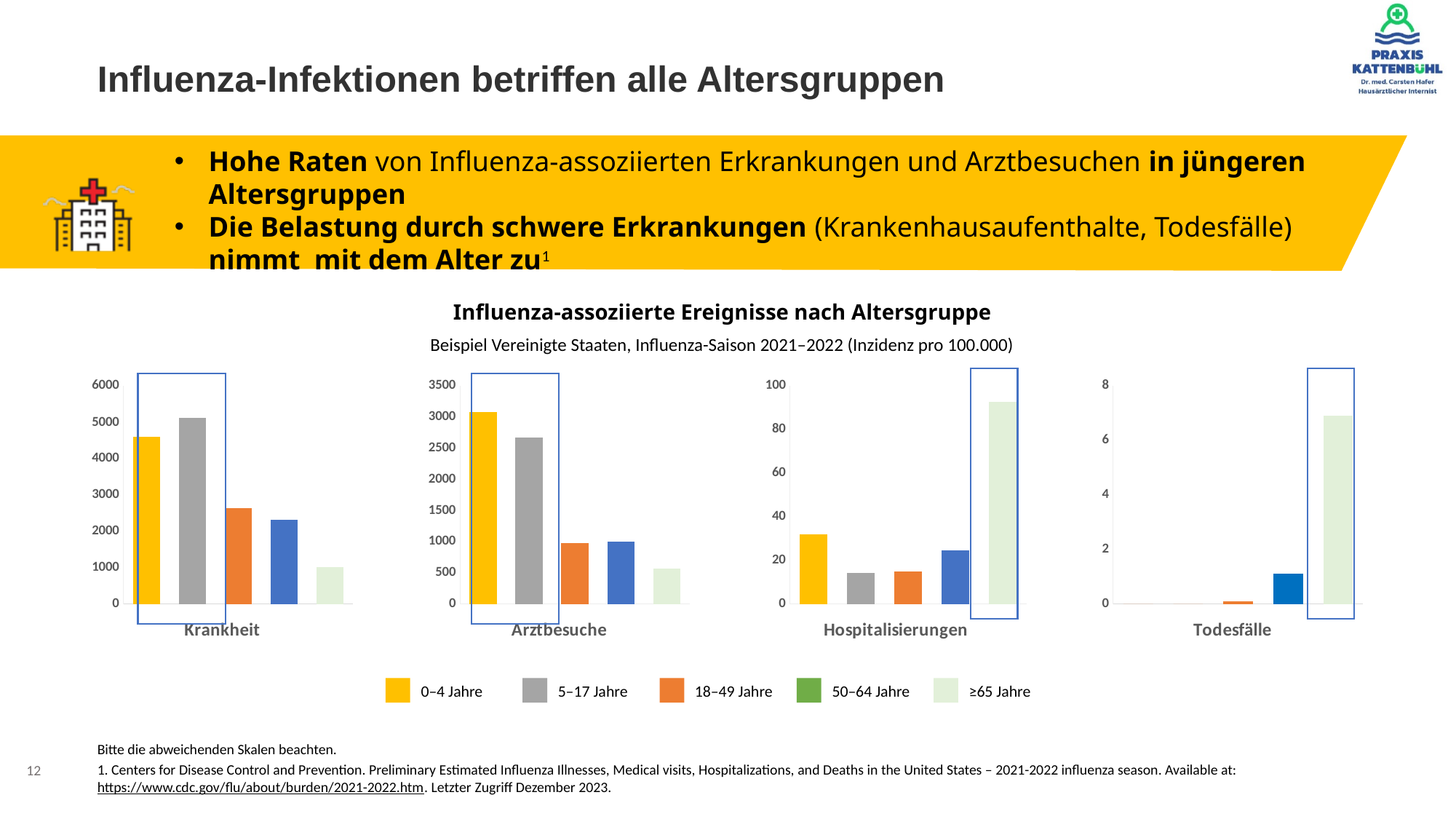
In the Arztbesuche chart, which age group has the highest value? 0–4 Jahre In the Hospitalisierungen chart, which age group has the highest value? ≥65 Jahre In the Krankheit chart, which age group has the highest value? 5–17 Jahre How many separate charts (panels) are shown on the slide? 4 In the Hospitalisierungen chart, is the value for ≥65 Jahre greater or less than 80? greater In the Krankheit chart, which age group has the lowest value? ≥65 Jahre How many age-group series does the legend list? 5 What kind of chart is used for the Krankheit panel? bar chart In the Krankheit chart, is the value for 0–4 Jahre greater or less than 4000? greater In the Krankheit chart, which is larger: the value for 18–49 Jahre or for 50–64 Jahre? 18–49 Jahre What is the main title above the four charts? Influenza-assoziierte Ereignisse nach Altersgruppe